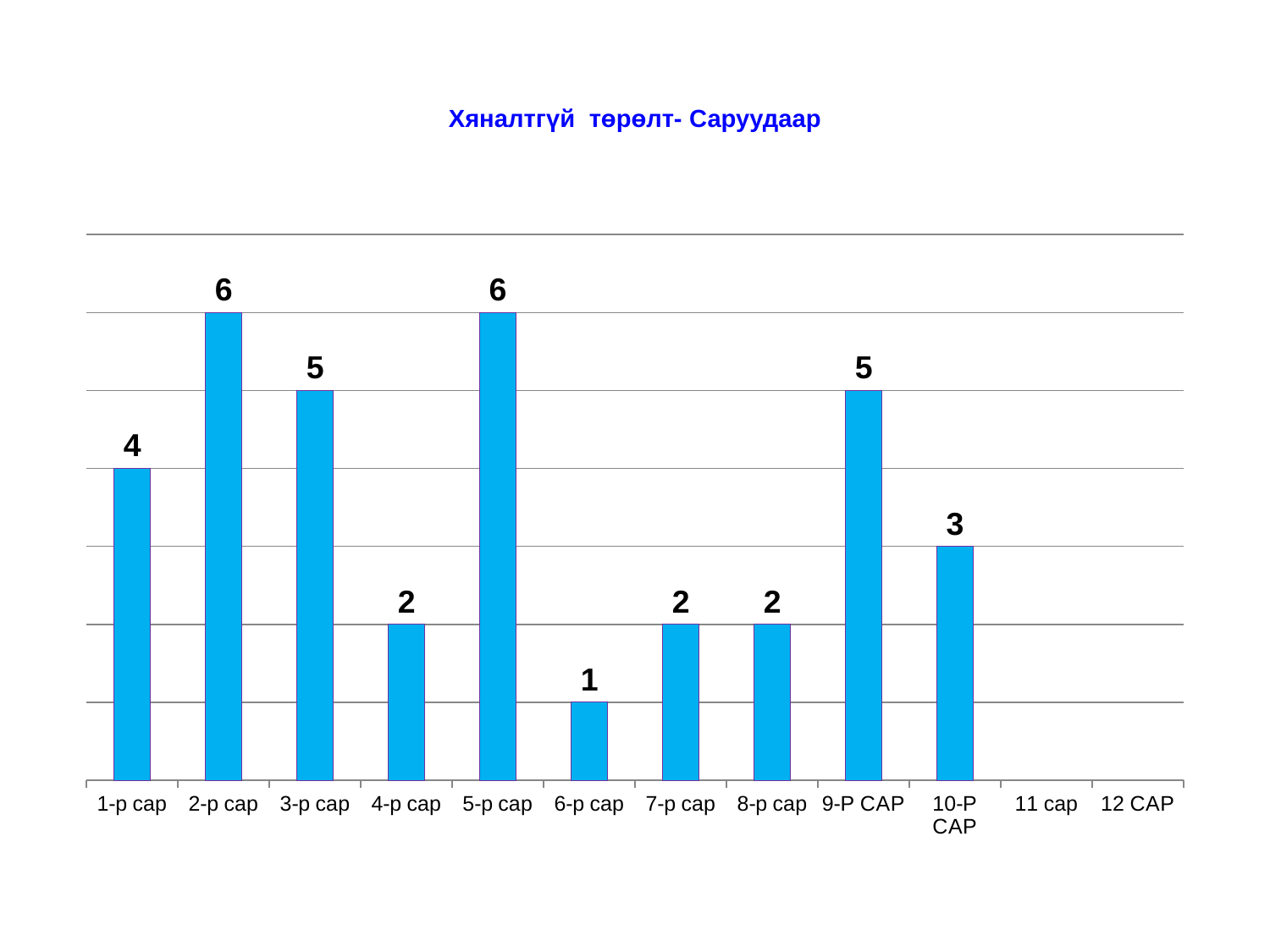
What is the difference between the values for 2-р сар and 4-р сар? 4 What is the value for 9-Р САР? 5 What is the value for 10-Р САР? 3 How many categories are shown on the x axis? 12 How many bars are plotted on the chart? 10 Which is larger, the value for 3-р сар or the value for 10-Р САР? 3-р сар Which month has the lowest plotted value? 6-р сар What is the title of the chart? Хяналтгүй төрөлт- Саруудаар Which two months share the highest value of 6? 2-р сар and 5-р сар What kind of chart is shown? Bar chart What is the value for 1-р сар? 4 Which two months on the x axis have no bar plotted? 11 сар and 12 САР